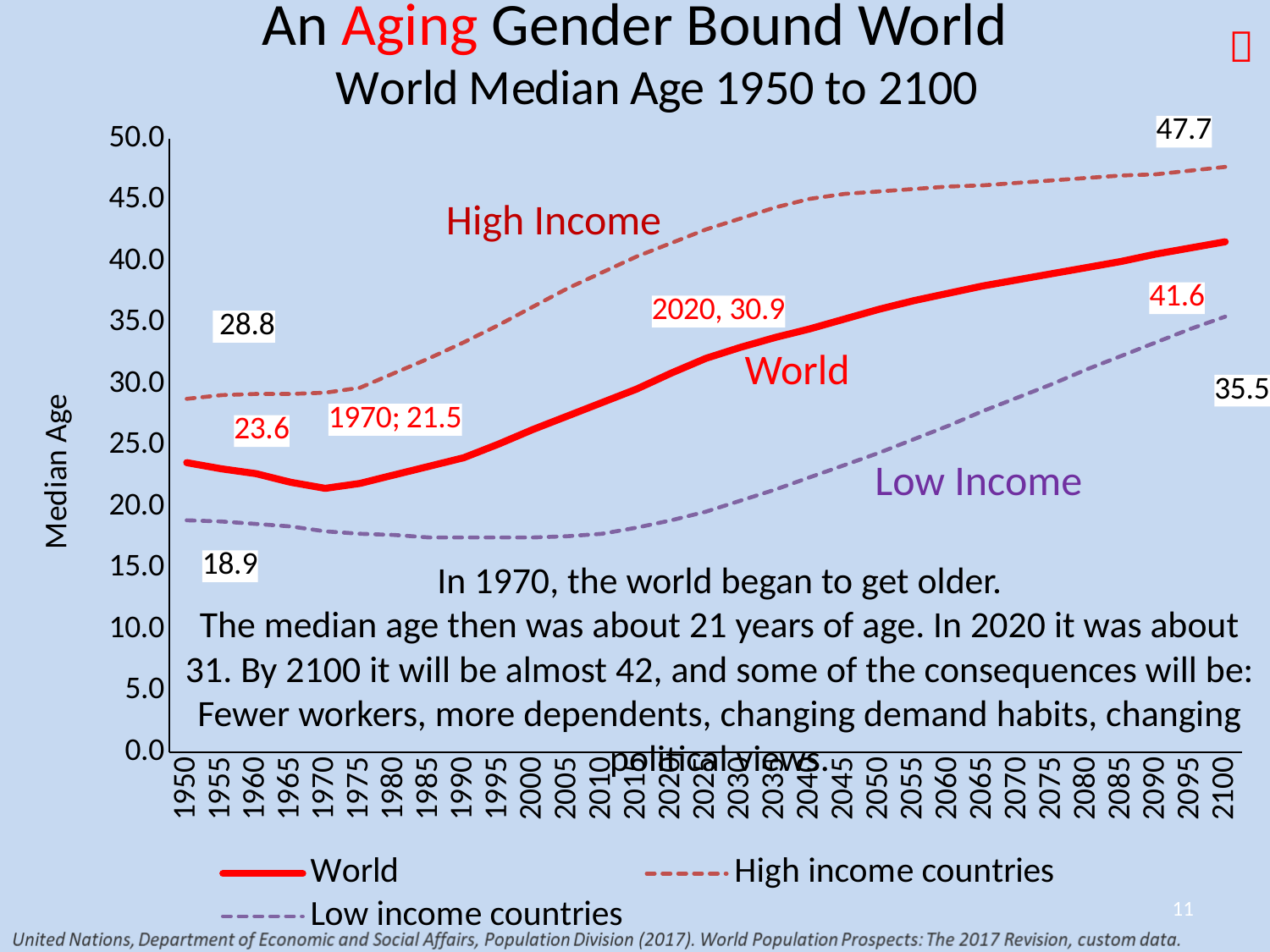
What is the difference between the High income and Low income median ages in 2100? 12.2 Is the median age for High income countries in 2050 greater or less than 40.0? greater What is the World median age in 1950? 23.6 Which series has the highest median age in 2100? High income countries Which series has the lowest median age in 1950? Low income countries What is the World median age in 2020? 30.9 How many series does the legend list? 3 What is the median age for High income countries in 2100? 47.7 What kind of chart is shown on the slide? Line chart What is the World median age in 1970? 21.5 What is the median age for Low income countries in 1950? 18.9 By how much does the World median age increase from 1950 to 2100? 18.0